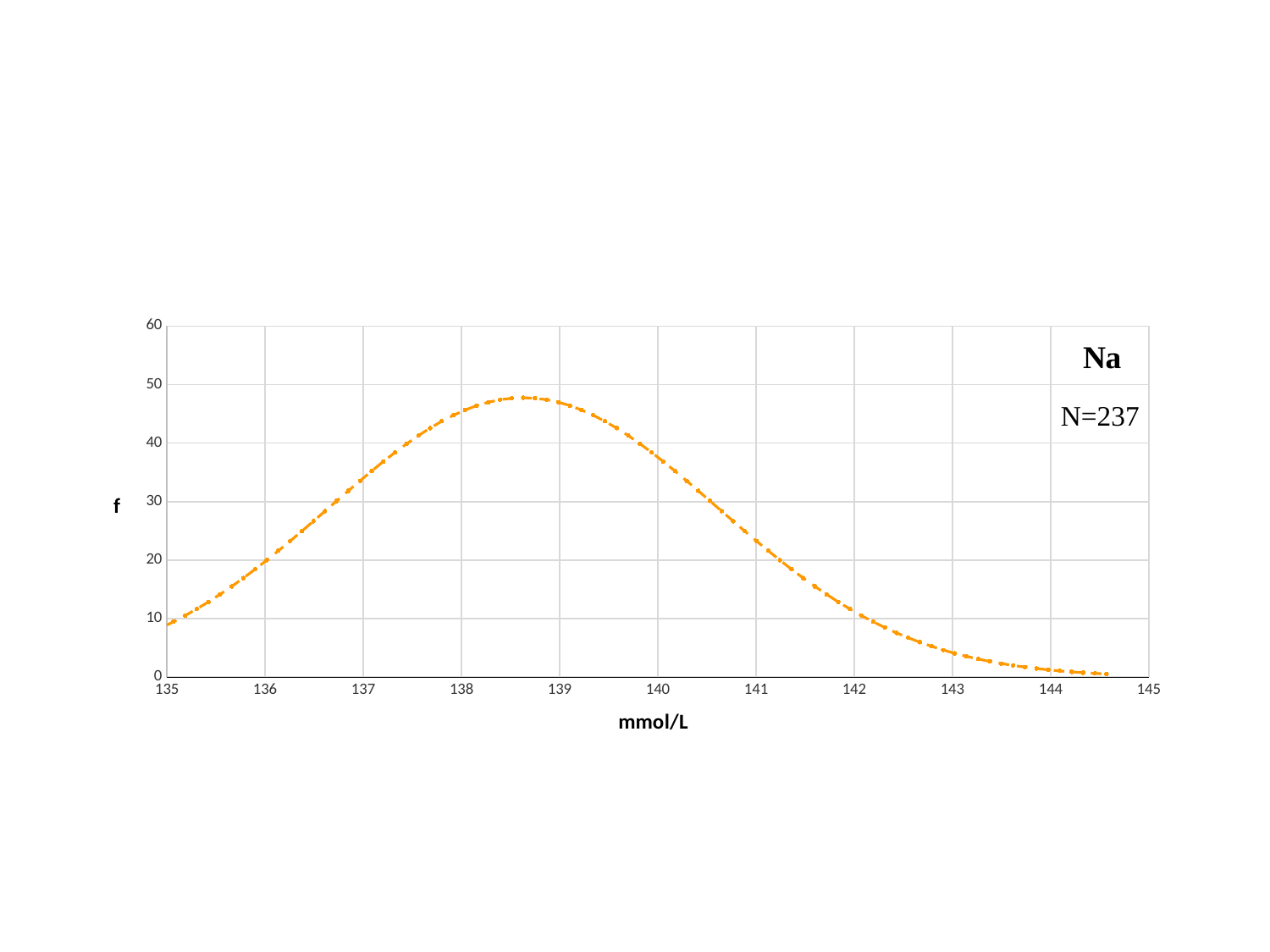
What kind of chart is shown on the slide? line chart What is the label on the x axis of the chart? mmol/L Does the curve rise or fall between 140 and 144 mmol/L? fall Is the peak value of the curve greater or less than 40? greater Which is larger, the value of the curve at 137 mmol/L or at 142 mmol/L? 137 mmol/L Is the value of the curve at 137 mmol/L greater or less than 30? greater What sample size (N) is shown on the chart? N=237 Is the value of the curve at 141 mmol/L greater or less than 20? greater Does the curve rise or fall between 135 and 138 mmol/L? rise